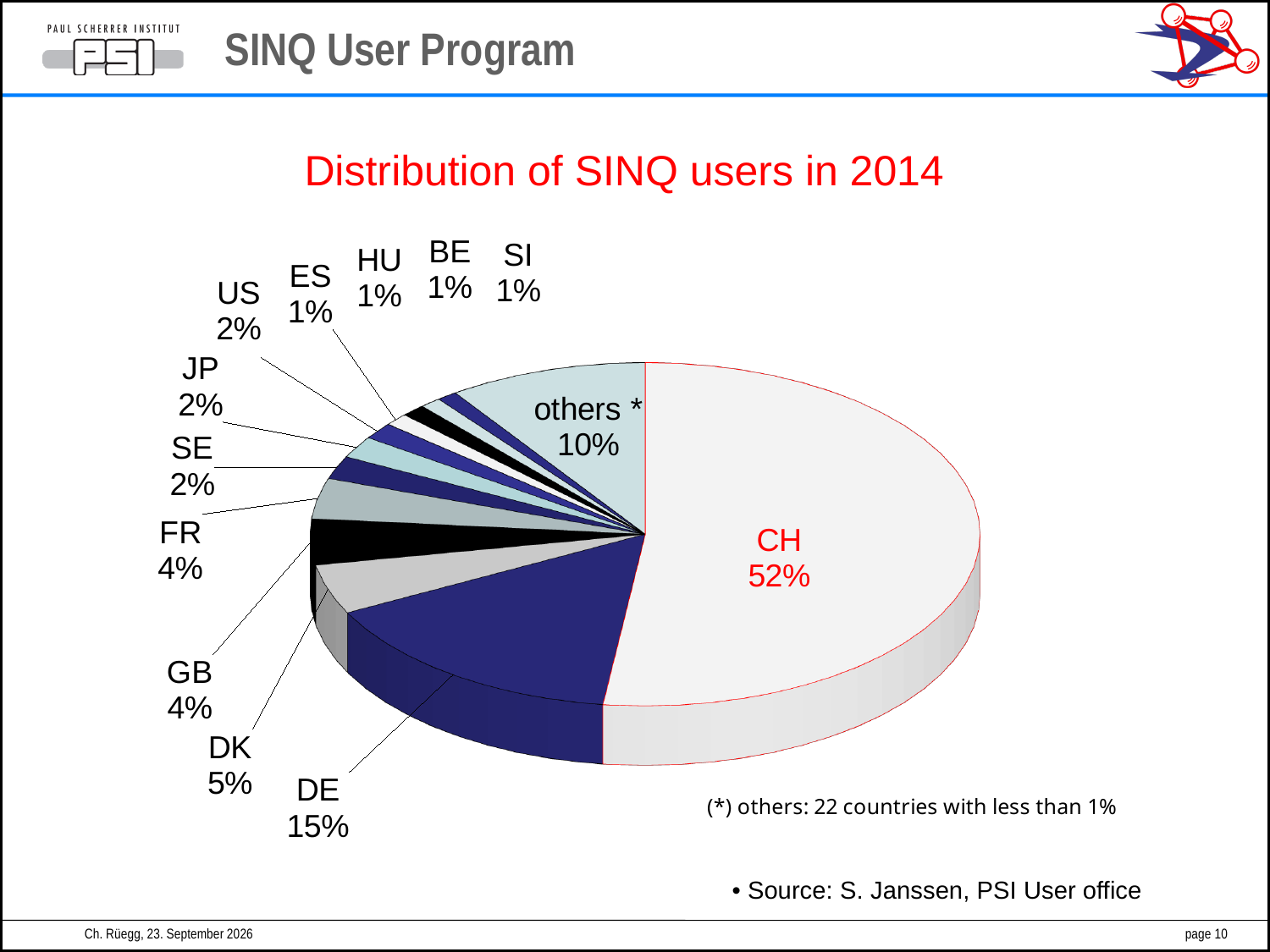
What is the difference in percentage points between the CH and DE shares? 37 How many slices does the pie chart have? 13 What type of chart is shown on the slide? pie chart According to the footnote, how many countries are grouped under 'others'? 22 countries What is the percentage shown for DK? 5% What is the combined share of FR and GB? 8% What share of SINQ users in 2014 came from DE? 15% What share of SINQ users in 2014 came from CH? 52% What percentage of SINQ users is attributed to 'others *'? 10% Which has a larger share, DK or GB? DK What is the title of the chart? Distribution of SINQ users in 2014 Which country has the largest share of SINQ users in 2014? CH